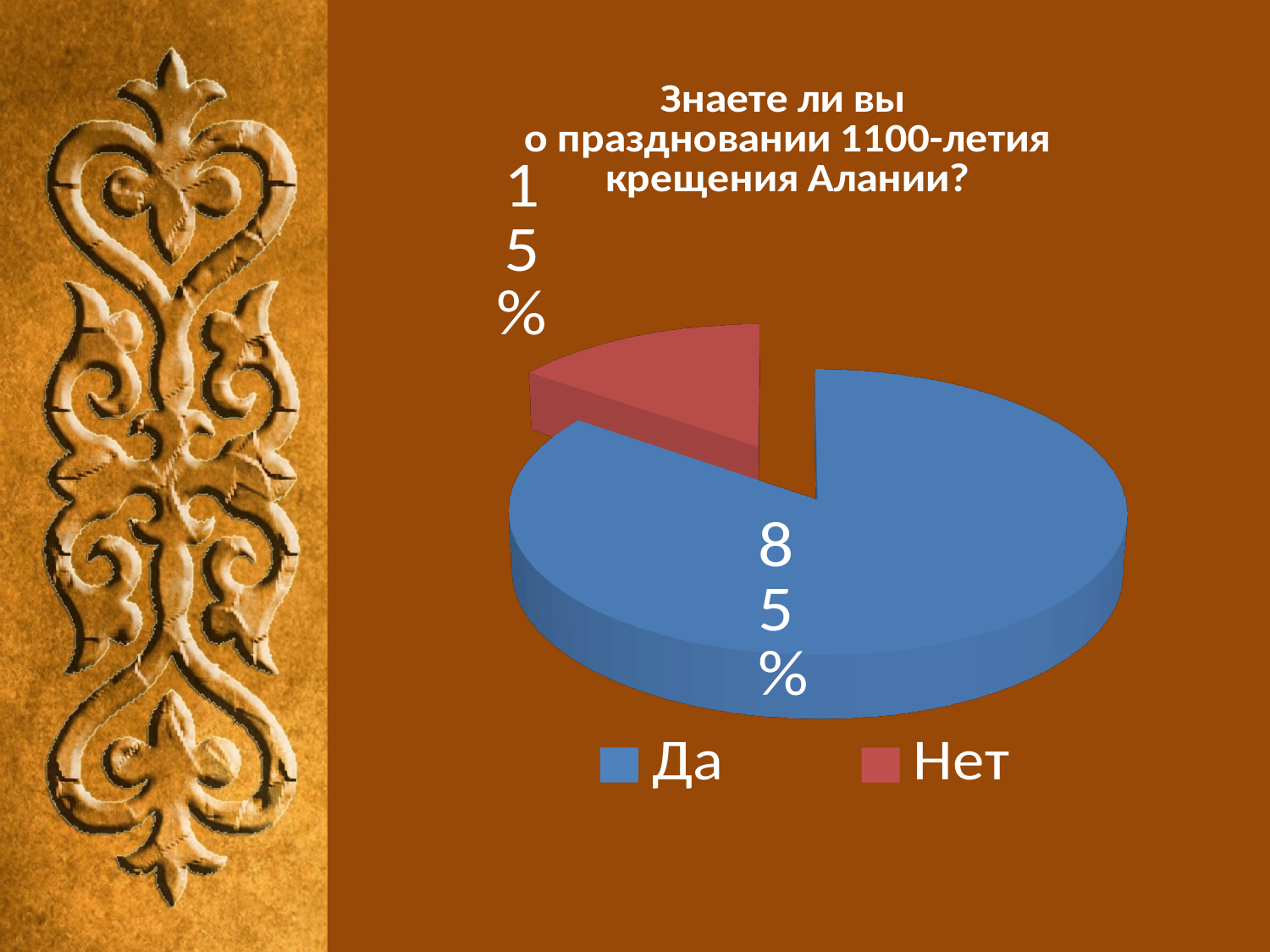
Which category has the largest share of the pie? Да What colour is the "Нет" slice? red What percentage of respondents answered "Да"? 85% Which is larger, the share for "Да" or the share for "Нет"? Да What is the title of the chart? Знаете ли вы о праздновании 1100-летия крещения Алании? Is the share for "Да" greater or less than 50%? greater What is the difference in percentage points between "Да" and "Нет"? 70 How many categories does the pie chart show? 2 What kind of chart is shown on the slide? pie chart Which category has the smallest share of the pie? Нет What percentage of respondents answered "Нет"? 15%